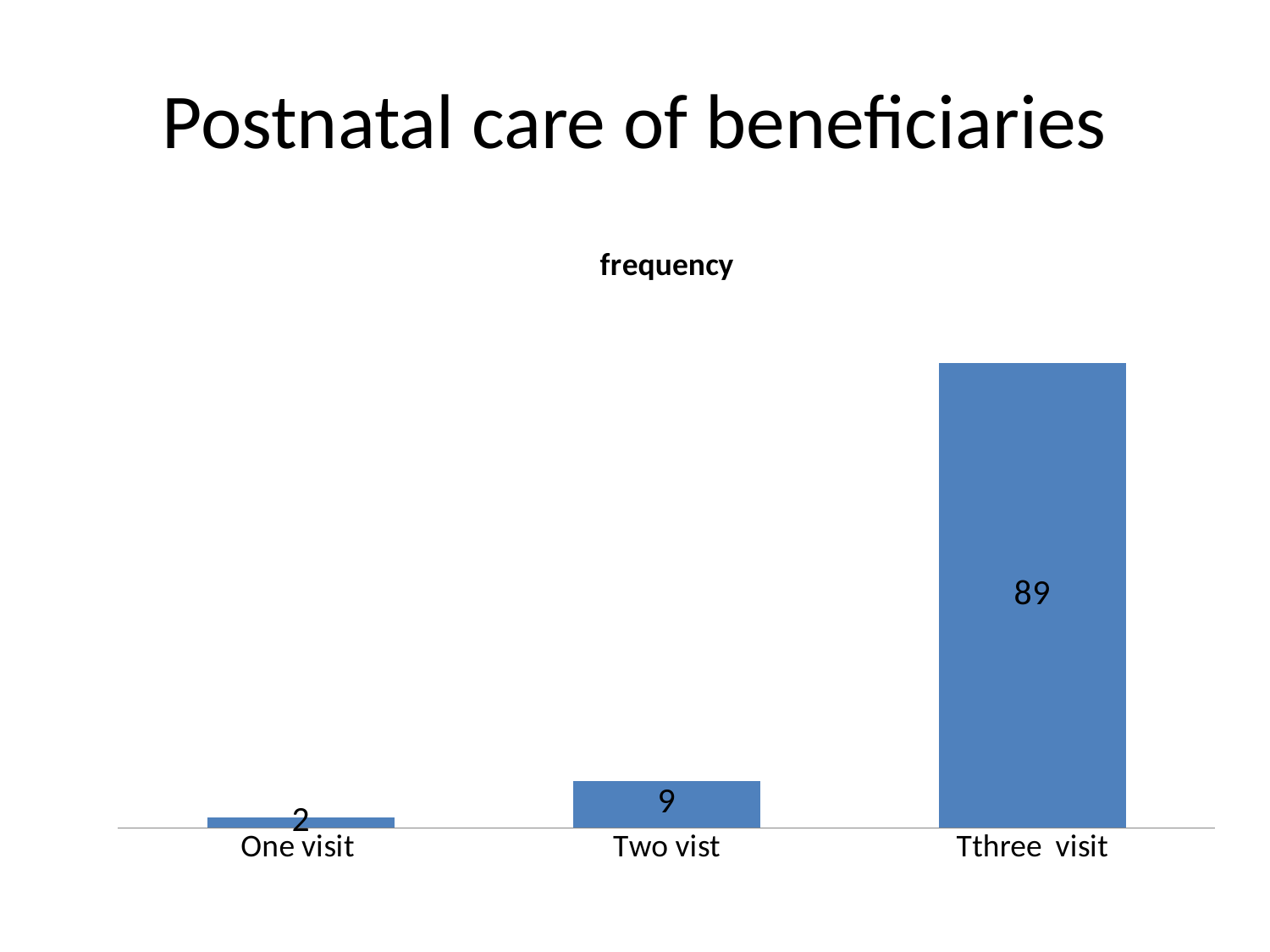
How many categories are shown on the x axis? 3 Which has a larger frequency, One visit or Two vist? Two vist What is the frequency for One visit? 2 What is the frequency for Tthree visit? 89 What is the frequency for Two vist? 9 What is the difference in frequency between Tthree visit and Two vist? 80 Which category has the lowest frequency? One visit What is the title of the chart? frequency What is the difference in frequency between Two vist and One visit? 7 What kind of chart is shown on the slide? Bar chart Do the values rise or fall from One visit to Tthree visit? Rise Which category has the highest frequency? Tthree visit